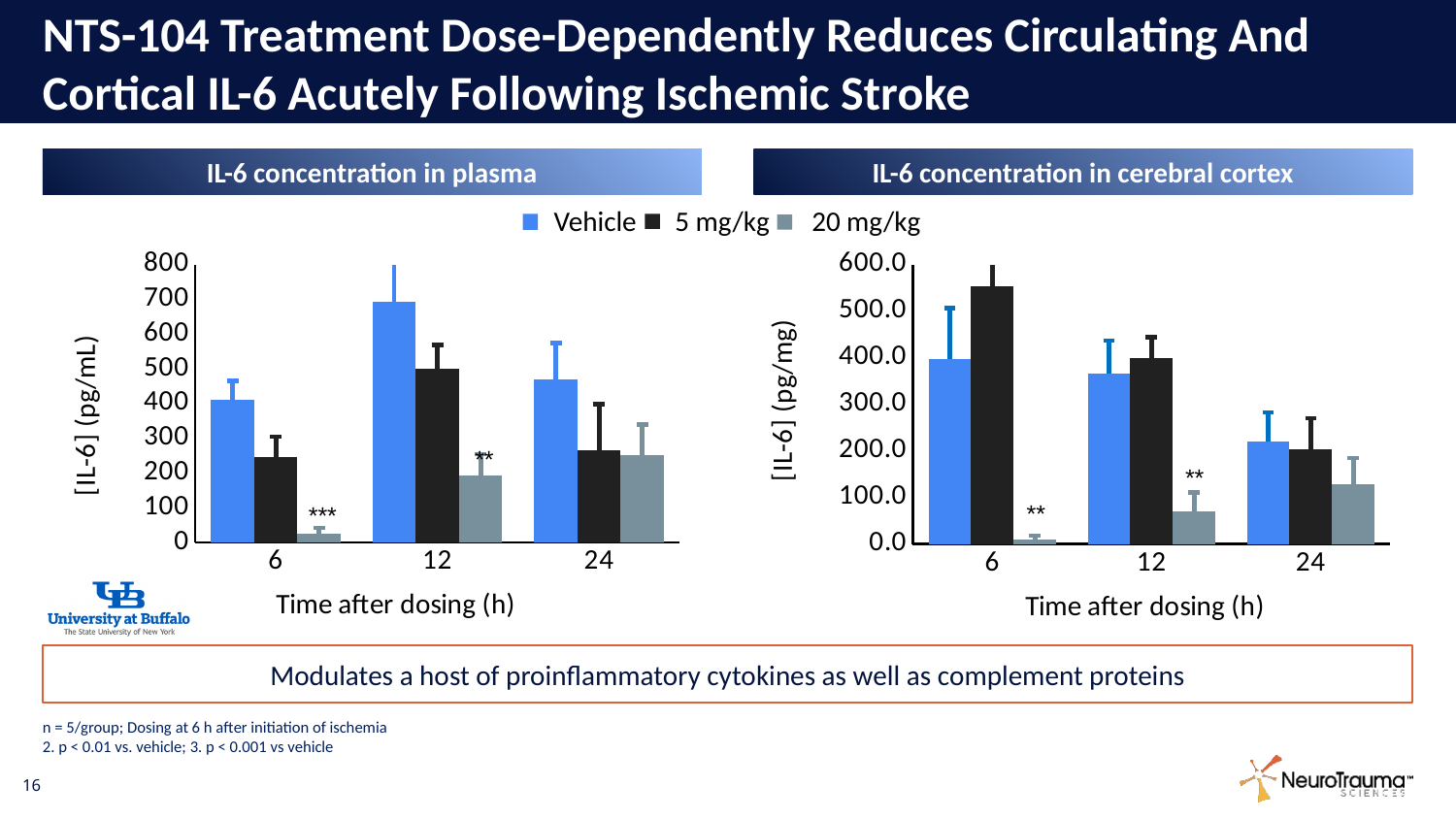
In the 'IL-6 concentration in cerebral cortex' chart, which series has the highest bar at 6 h? 5 mg/kg What is the y-axis label of the 'IL-6 concentration in cerebral cortex' chart? [IL-6] (pg/mg) In the 'IL-6 concentration in plasma' chart, is the 20 mg/kg value at 6 h greater or less than 100? less How many series does the legend list for the charts? 3 In the 'IL-6 concentration in cerebral cortex' chart, how many time points are shown on the x axis? 3 What kind of chart is the 'IL-6 concentration in plasma' chart? bar chart In the 'IL-6 concentration in plasma' chart, at which time after dosing is the Vehicle bar highest? 12 In the 'IL-6 concentration in cerebral cortex' chart, is the 5 mg/kg value at 6 h greater or less than 500.0? greater In the 'IL-6 concentration in plasma' chart, is the Vehicle value at 12 h greater or less than 600? greater In the 'IL-6 concentration in plasma' chart, at 12 h, which is larger: Vehicle or 5 mg/kg? Vehicle In the 'IL-6 concentration in cerebral cortex' chart, do the 20 mg/kg values rise or fall from 6 h to 24 h? rise In the 'IL-6 concentration in plasma' chart, which series and time point has the lowest bar? 20 mg/kg at 6